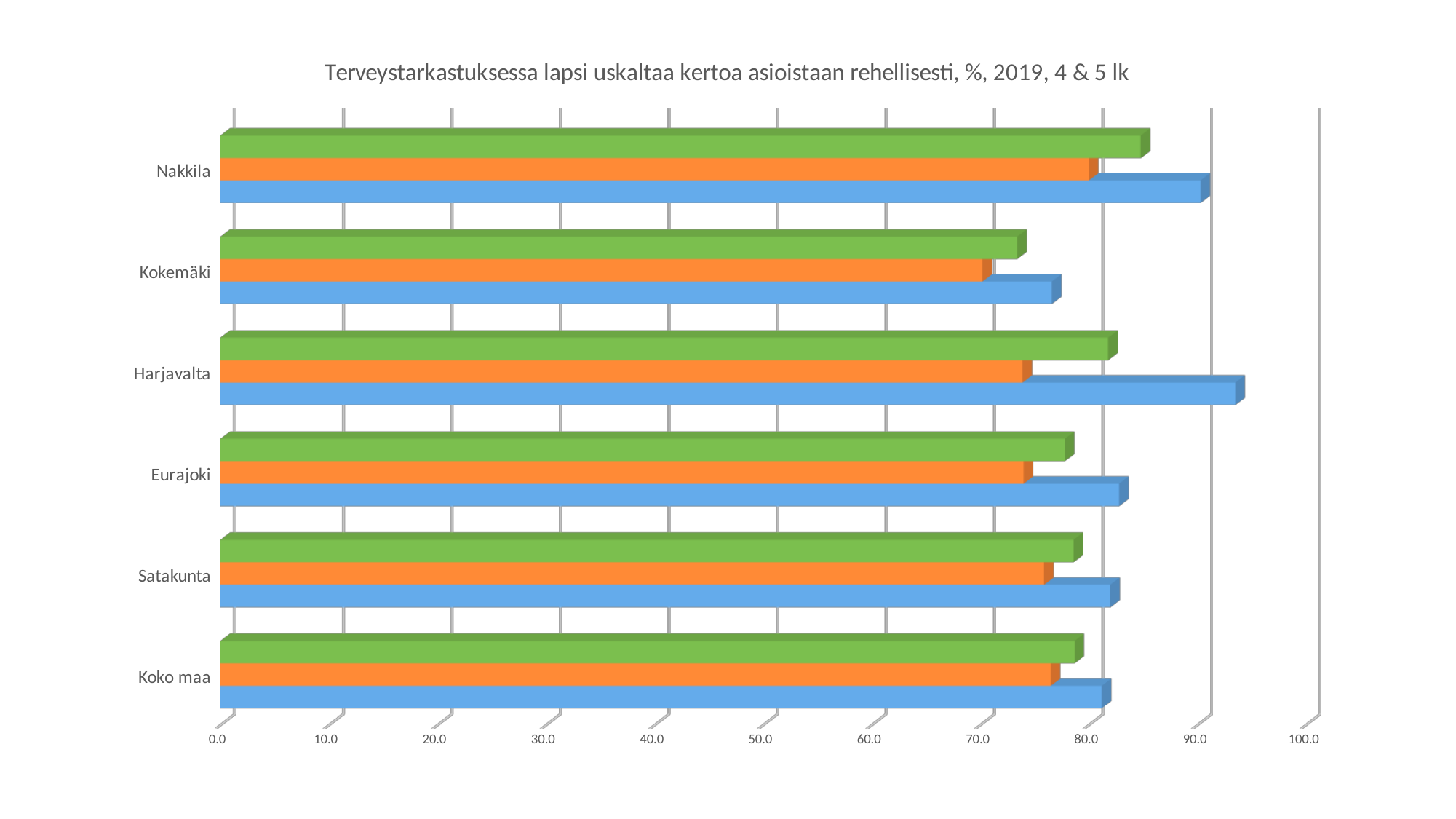
Which category has the shortest green bar? Kokemäki How many bars are plotted for each category in the chart? 3 Is the value of the blue bar for Kokemäki greater or less than 80.0? less Which category has the shortest blue bar? Kokemäki Which category has the longest blue bar? Harjavalta Which category has the longest green bar? Nakkila Is the value of the blue bar for Harjavalta greater or less than 90.0? greater How many categories (areas) are shown on the vertical axis of the chart? 6 What is the title of the chart? Terveystarkastuksessa lapsi uskaltaa kertoa asioistaan rehellisesti, %, 2019, 4 & 5 lk What kind of chart is shown on the slide? bar chart Which is larger, the blue bar for Nakkila or the blue bar for Kokemäki? Nakkila Which category has the shortest orange bar? Kokemäki